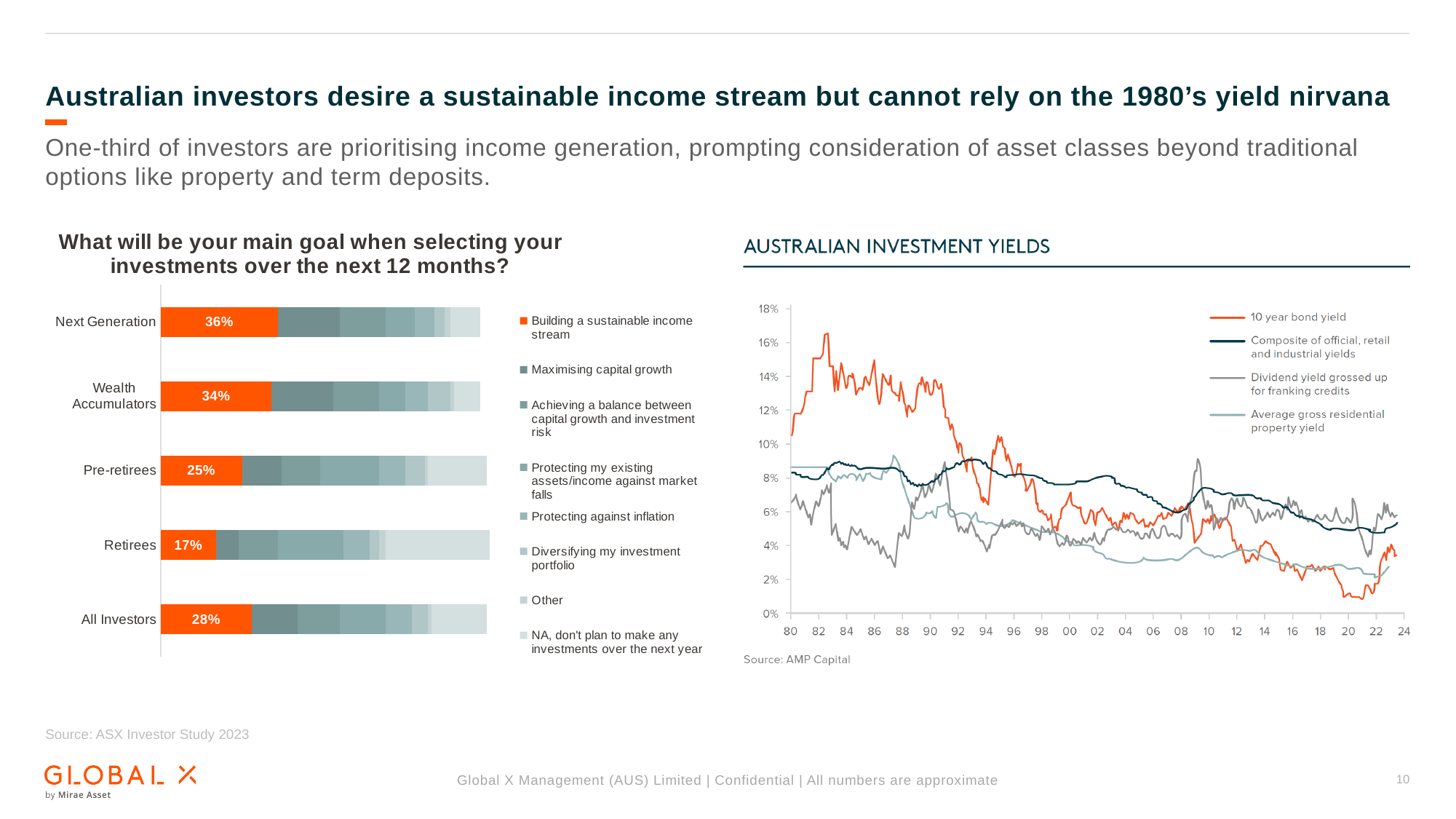
In the chart 'What will be your main goal when selecting your investments over the next 12 months?', what is the 'Building a sustainable income stream' value for Retirees? 17% In the chart 'What will be your main goal when selecting your investments over the next 12 months?', what is the difference between the 'Building a sustainable income stream' values for Next Generation and Retirees? 19% In the 'Australian Investment Yields' chart, does the 10 year bond yield generally rise or fall from 1980 to 2024? Fall How many series does the legend list in the 'Australian Investment Yields' chart? 4 In the chart 'What will be your main goal when selecting your investments over the next 12 months?', which investor group has the lowest share for 'Building a sustainable income stream'? Retirees In the chart 'What will be your main goal when selecting your investments over the next 12 months?', which has a larger 'Building a sustainable income stream' share: Wealth Accumulators or Pre-retirees? Wealth Accumulators How many investor groups are shown in the chart 'What will be your main goal when selecting your investments over the next 12 months?'? 5 What kind of chart is 'Australian Investment Yields'? Line chart In the chart 'What will be your main goal when selecting your investments over the next 12 months?', what percentage of Next Generation investors chose 'Building a sustainable income stream'? 36% How many series does the legend list in the chart 'What will be your main goal when selecting your investments over the next 12 months?'? 8 In the chart 'What will be your main goal when selecting your investments over the next 12 months?', which investor group has the highest share for 'Building a sustainable income stream'? Next Generation In the chart 'What will be your main goal when selecting your investments over the next 12 months?', what is the 'Building a sustainable income stream' value for All Investors? 28%